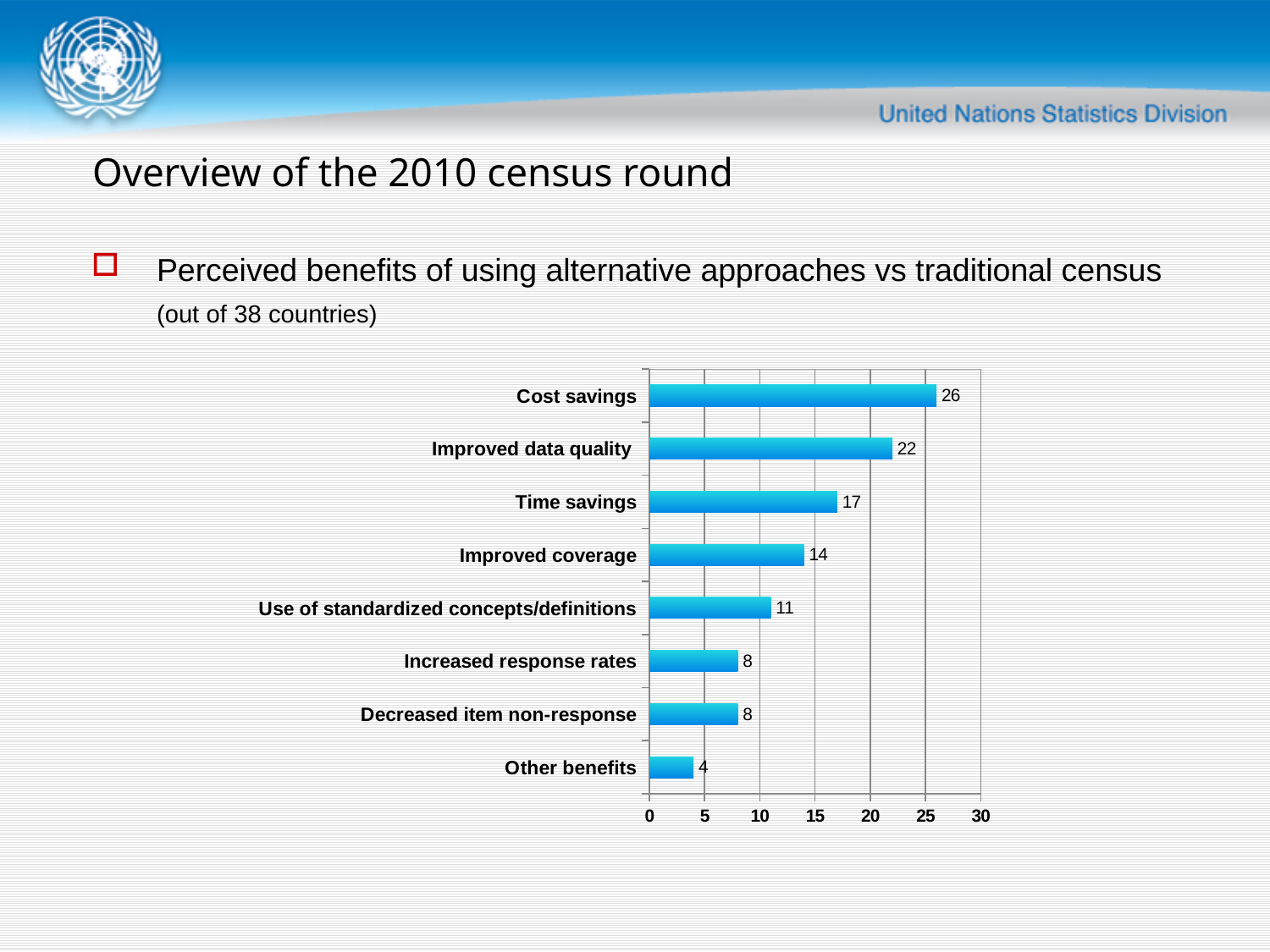
What is the value for Use of standardized concepts/definitions? 11 Is the value for Improved data quality greater or less than 20? greater Which category has the lowest value? Other benefits What is the value for Improved data quality? 22 What is the value for Other benefits? 4 What is the maximum value shown on the horizontal axis? 30 Which category has the highest value? Cost savings How many categories are shown in the chart? 8 What is the value for Cost savings? 26 What kind of chart is shown on the slide? Bar chart What is the difference between the values for Cost savings and Time savings? 9 Which is larger, the value for Improved coverage or the value for Increased response rates? Improved coverage